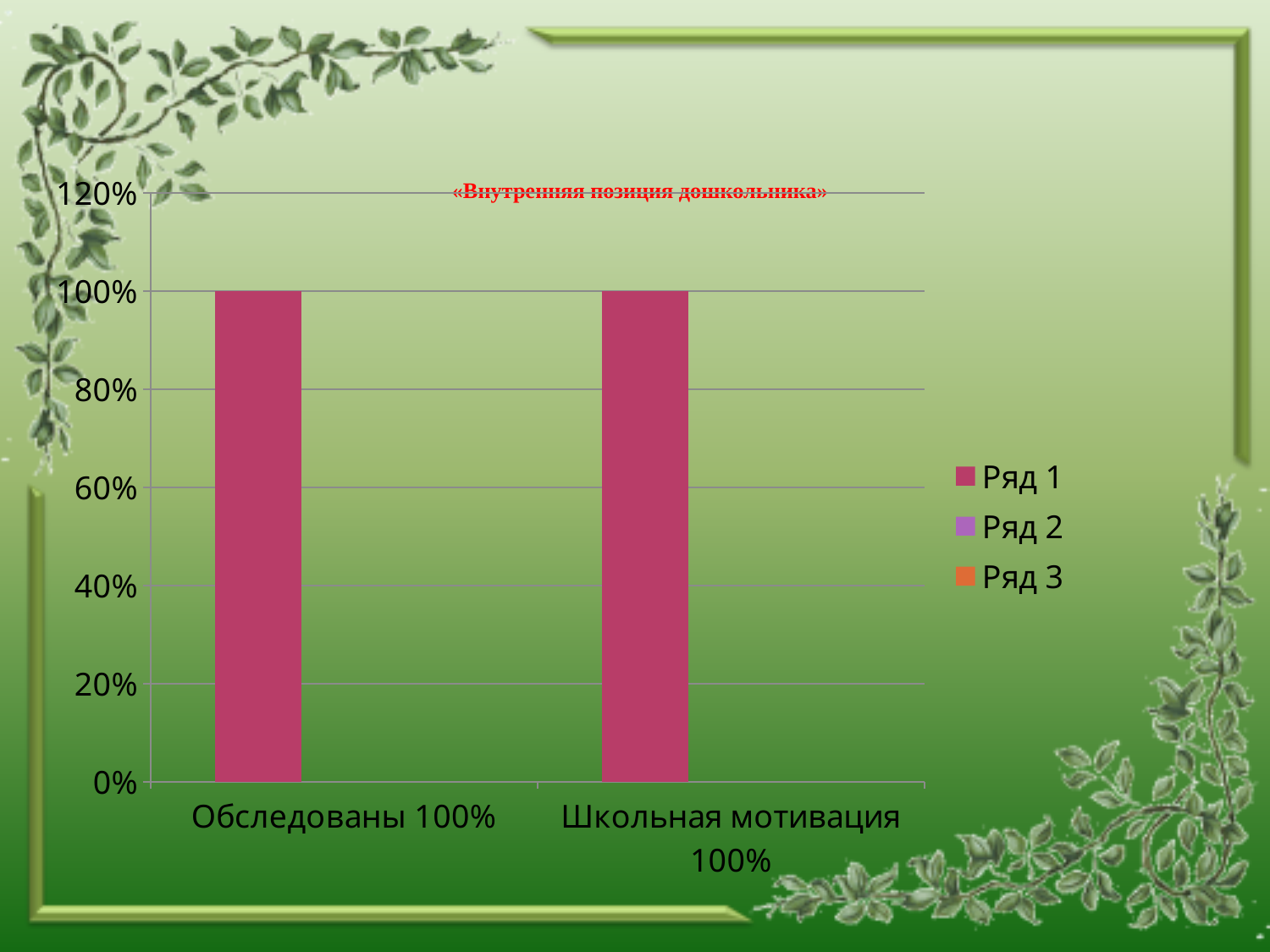
Is the value for "Обследованы 100%" greater or less than 60%? greater What is the highest value shown on the y axis? 120% What kind of chart is shown on the slide? bar chart What is the difference between the values for "Обследованы 100%" and "Школьная мотивация 100%"? 0% What is the value of the bar for "Школьная мотивация 100%"? 100% Is the value for "Школьная мотивация 100%" greater or less than 80%? greater What is the title of the chart? «Внутренняя позиция дошкольника» What is the name of the first series in the legend? Ряд 1 How many series does the legend list? 3 How many categories are shown on the x axis of the chart? 2 Do the bar values rise, fall or stay the same from the first category to the second? stay the same What is the value of the bar for "Обследованы 100%"? 100%